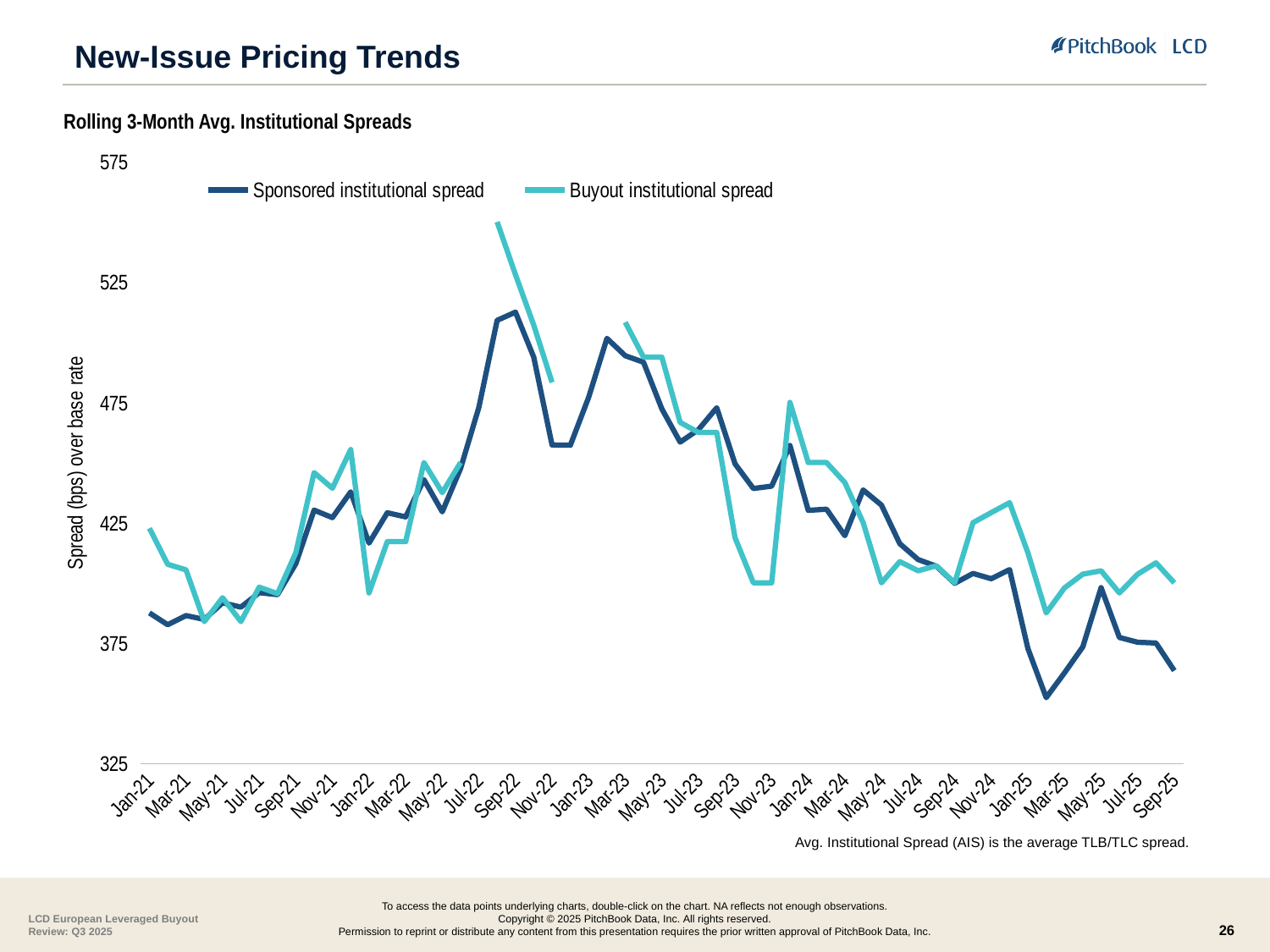
Is the Buyout institutional spread at Nov-23 greater or less than 425? less Does the Sponsored institutional spread generally rise or fall from Mar-23 to Mar-25? fall Is the Sponsored institutional spread at Mar-25 greater or less than 375? less What is the label on the vertical axis of the chart? Spread (bps) over base rate Around which x-axis label does the Sponsored institutional spread reach its highest point? Sep-22 Is the Sponsored institutional spread at Sep-22 greater or less than 475? greater What is the title of the chart? Rolling 3-Month Avg. Institutional Spreads How many series does the legend list? 2 What kind of chart is shown on the slide? Line chart At Sep-25, which series is higher: Sponsored institutional spread or Buyout institutional spread? Buyout institutional spread